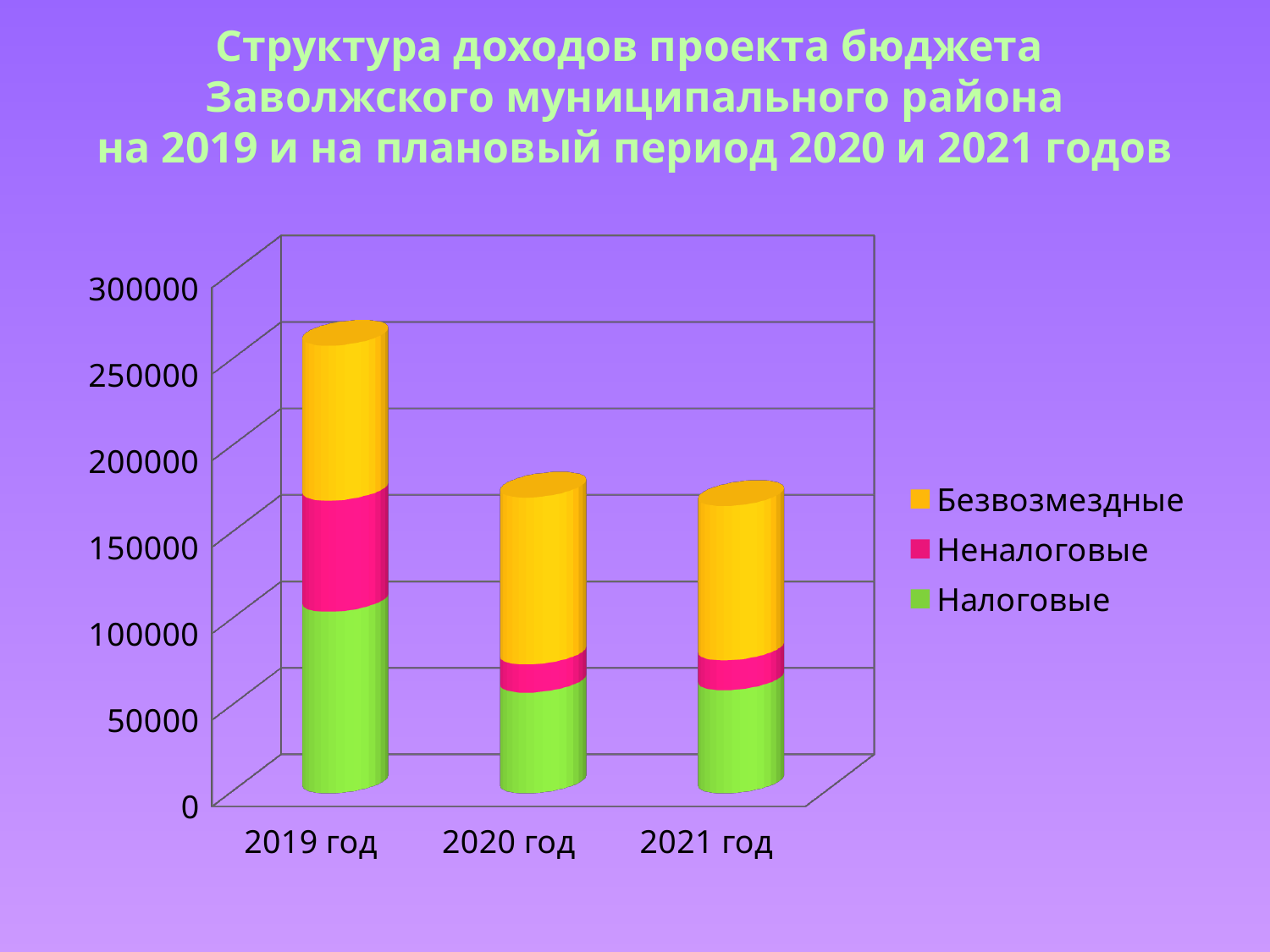
Which is larger: the Неналоговые value for 2019 год or for 2020 год? 2019 год Is the Налоговые value for 2019 год greater or less than 150000? less Is the Налоговые value for 2020 год greater or less than 100000? less What kind of chart is shown on the slide? Stacked bar chart How many years (categories) are shown on the x axis? 3 Is the total for 2021 год greater or less than 150000? greater How many series does the legend list? 3 Which series is the smallest segment in the 2020 год bar? Неналоговые Which colour represents Налоговые in the legend? Green Which year has the highest total income? 2019 год